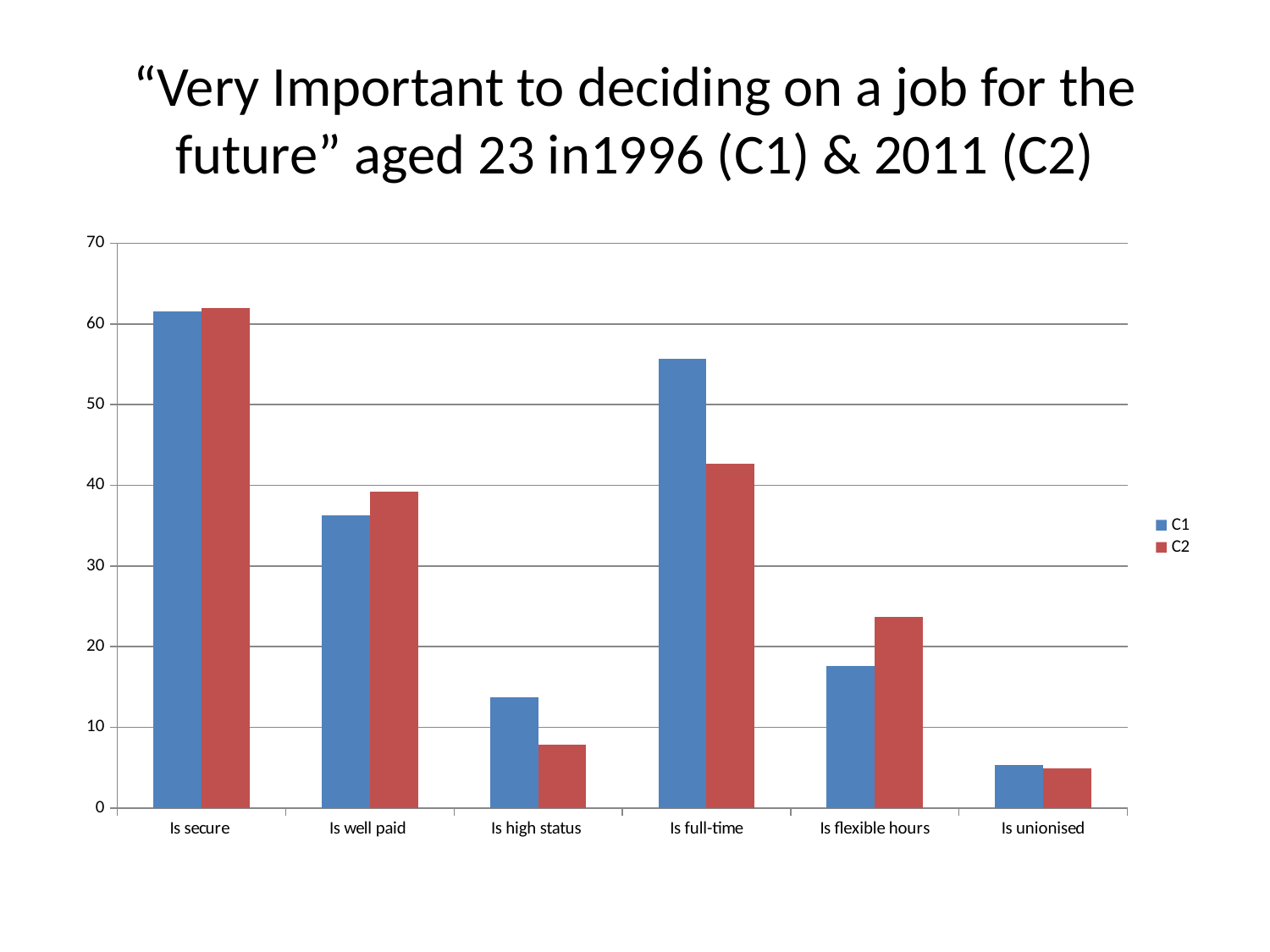
Is the C2 value for Is high status greater or less than 10? less Which category has the highest value for C1? Is secure For Is full-time, which series has the larger value, C1 or C2? C1 How many categories are shown on the x axis? 6 Which category has the highest value for C2? Is secure How many series does the legend list? 2 What kind of chart is shown on the slide? bar chart For Is flexible hours, which series has the larger value, C1 or C2? C2 Which category has the lowest value for C1? Is unionised What colour are the C2 bars? red Is the C1 value for Is full-time greater or less than 50? greater Which category has the lowest value for C2? Is unionised